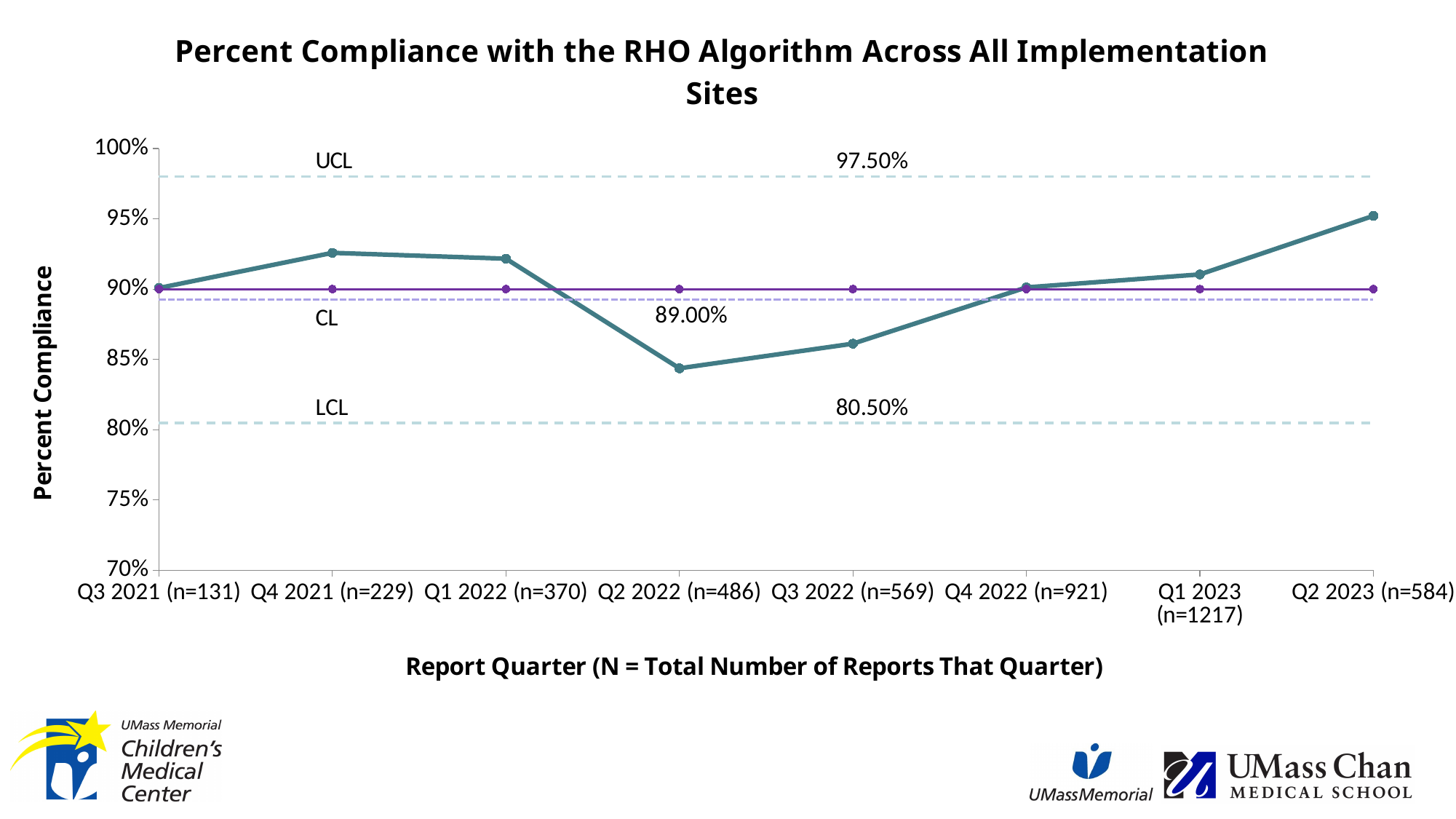
What kind of chart is shown on the slide? line chart Which report quarter has the highest percent compliance? Q2 2023 (n=584) Does percent compliance rise or fall from Q3 2022 to Q2 2023? rise Is the percent compliance for Q2 2022 (n=486) greater or less than 85%? less How many report quarters are plotted on the x axis? 8 What is the value of the lower control limit (LCL) shown on the chart? 80.50% Which report quarter has the lowest percent compliance? Q2 2022 (n=486) Which has the higher percent compliance, Q4 2021 (n=229) or Q3 2022 (n=569)? Q4 2021 (n=229) What is the value of the center line (CL) shown on the chart? 89.00% What is the value of the upper control limit (UCL) shown on the chart? 97.50% What is the difference between the UCL and the LCL values printed on the chart? 17.00% Is the percent compliance for Q2 2023 (n=584) greater or less than 90%? greater